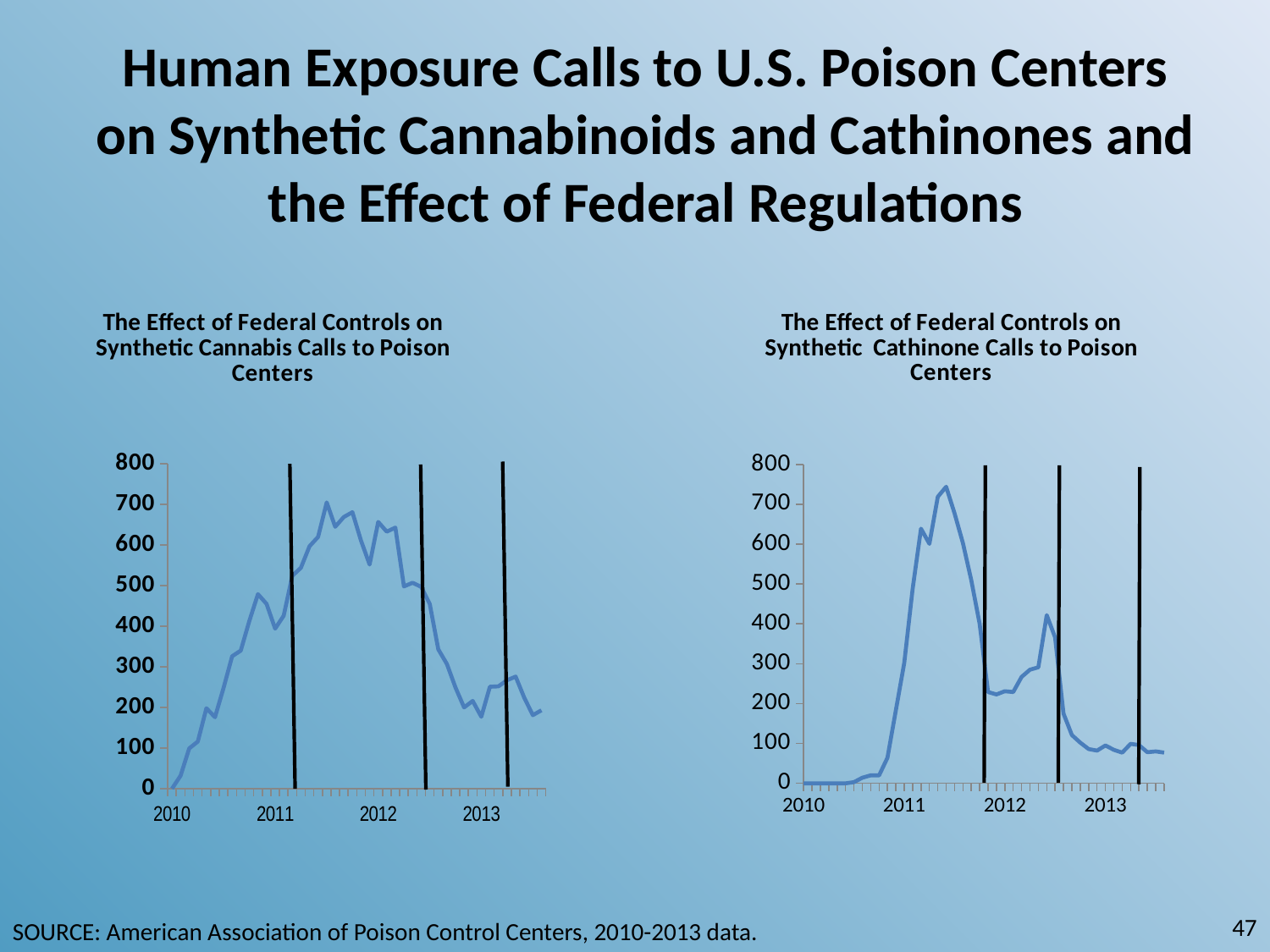
In the right chart (Synthetic Cathinone), is the final value at the end of the line in 2013 greater or less than 200? less In the right chart (Synthetic Cathinone), do the values rise or fall from 2012 to 2013? Fall In the left chart (Synthetic Cannabis), do the values rise or fall from 2010 to 2011? Rise Which chart shows the larger value at the start of 2011, the Synthetic Cannabis chart or the Synthetic Cathinone chart? Synthetic Cannabis chart What kind of chart is the left chart, 'The Effect of Federal Controls on Synthetic Cannabis Calls to Poison Centers'? Line chart What kind of chart is the right chart, 'The Effect of Federal Controls on Synthetic Cathinone Calls to Poison Centers'? Line chart In the left chart (Synthetic Cannabis), is the peak value of the line greater or less than 600? greater What is the highest value shown on the y axis of the right chart (Synthetic Cathinone)? 800 In the right chart (Synthetic Cathinone), is the value at the start of 2010 greater or less than 100? less How many vertical black lines are drawn on the left chart (Synthetic Cannabis)? 3